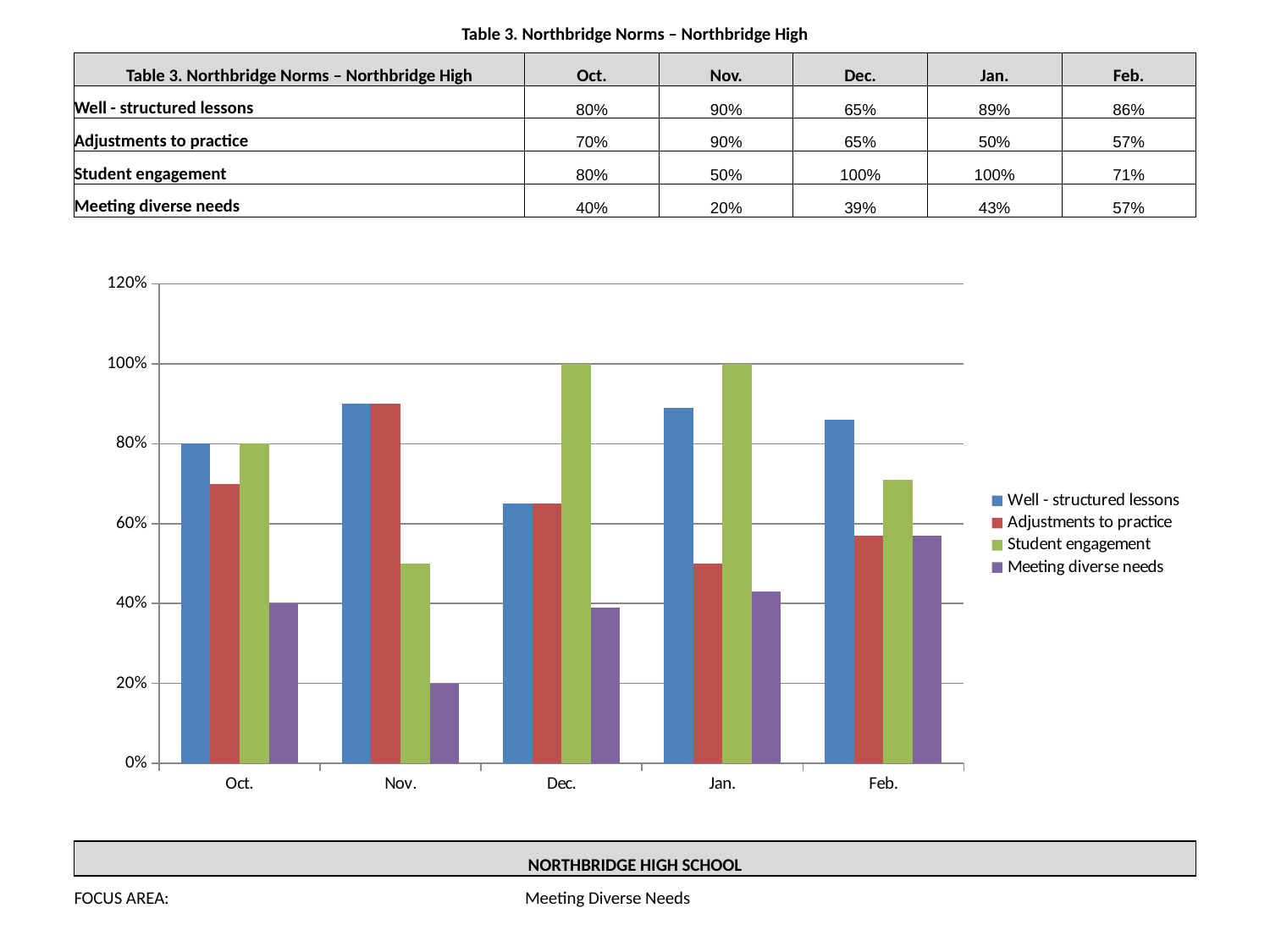
What is the difference between Well - structured lessons and Meeting diverse needs in Oct.? 40% How many series does the chart legend list? 4 In which month is Adjustments to practice lowest? Jan. What is the value for Student engagement in Dec.? 100% What kind of chart is shown on the slide? bar chart How many months are shown along the x axis of the chart? 5 What is the value for Well - structured lessons in Jan.? 89% In which month is Meeting diverse needs highest? Feb. Which is larger in Nov., Student engagement or Adjustments to practice? Adjustments to practice Which series is shown in green in the chart? Student engagement Is the value for Student engagement in Feb. greater or less than 60%? greater What is the value for Meeting diverse needs in Nov.? 20%